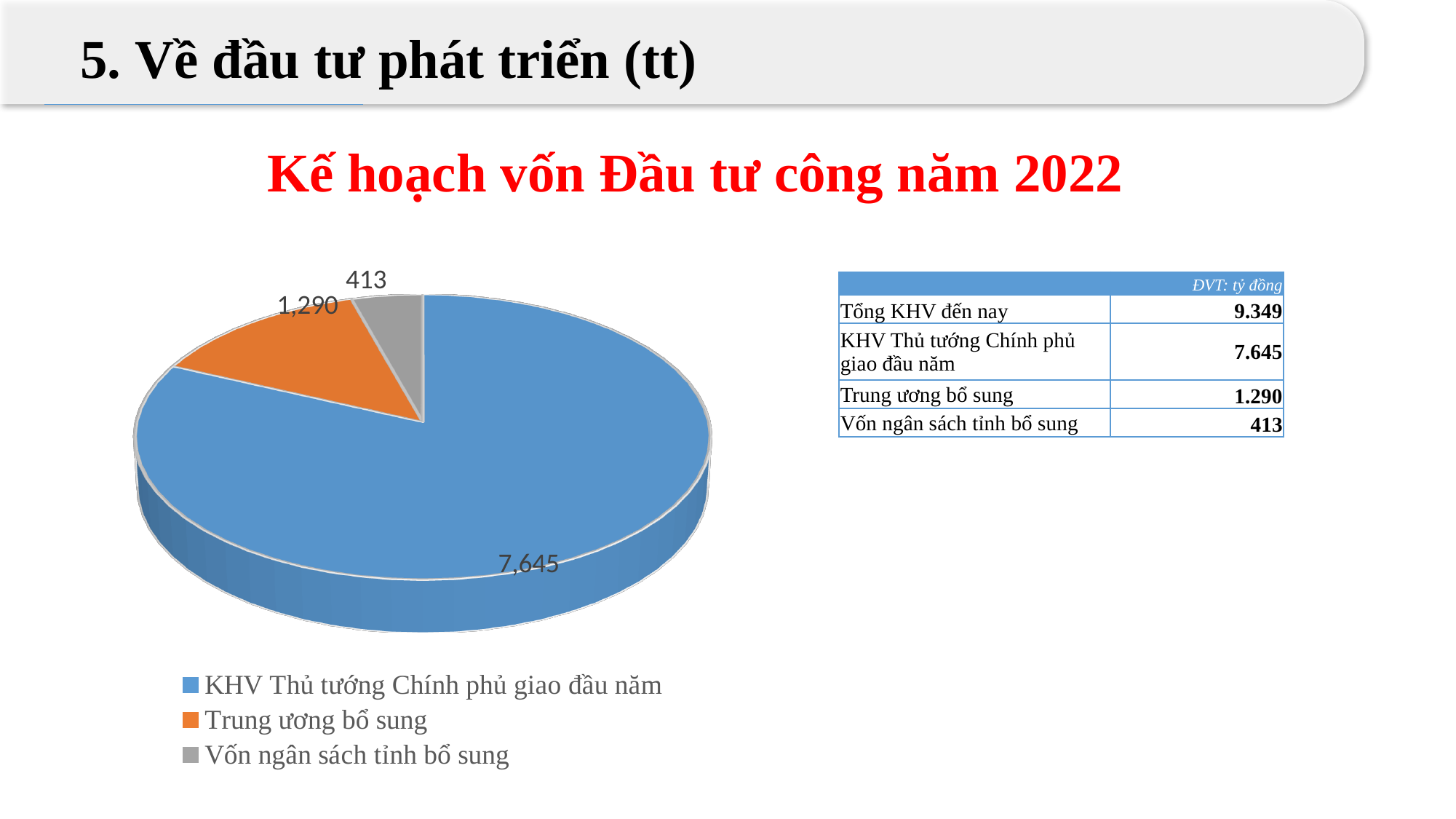
How many entries does the legend of the pie chart list? 3 Which is larger in the pie chart: Trung ương bổ sung or Vốn ngân sách tỉnh bổ sung? Trung ương bổ sung What is the value of the slice for KHV Thủ tướng Chính phủ giao đầu năm in the pie chart? 7,645 How many slices does the pie chart have? 3 What is the value of the slice for Vốn ngân sách tỉnh bổ sung in the pie chart? 413 Which category has the largest slice in the pie chart? KHV Thủ tướng Chính phủ giao đầu năm What colour is the slice for Trung ương bổ sung in the pie chart? orange Which category has the smallest slice in the pie chart? Vốn ngân sách tỉnh bổ sung What is the value of the slice for Trung ương bổ sung in the pie chart? 1,290 What is the difference between the values for Trung ương bổ sung and Vốn ngân sách tỉnh bổ sung in the pie chart? 877 What kind of chart is shown on the slide? pie chart What is the difference between the values for KHV Thủ tướng Chính phủ giao đầu năm and Trung ương bổ sung in the pie chart? 6,355